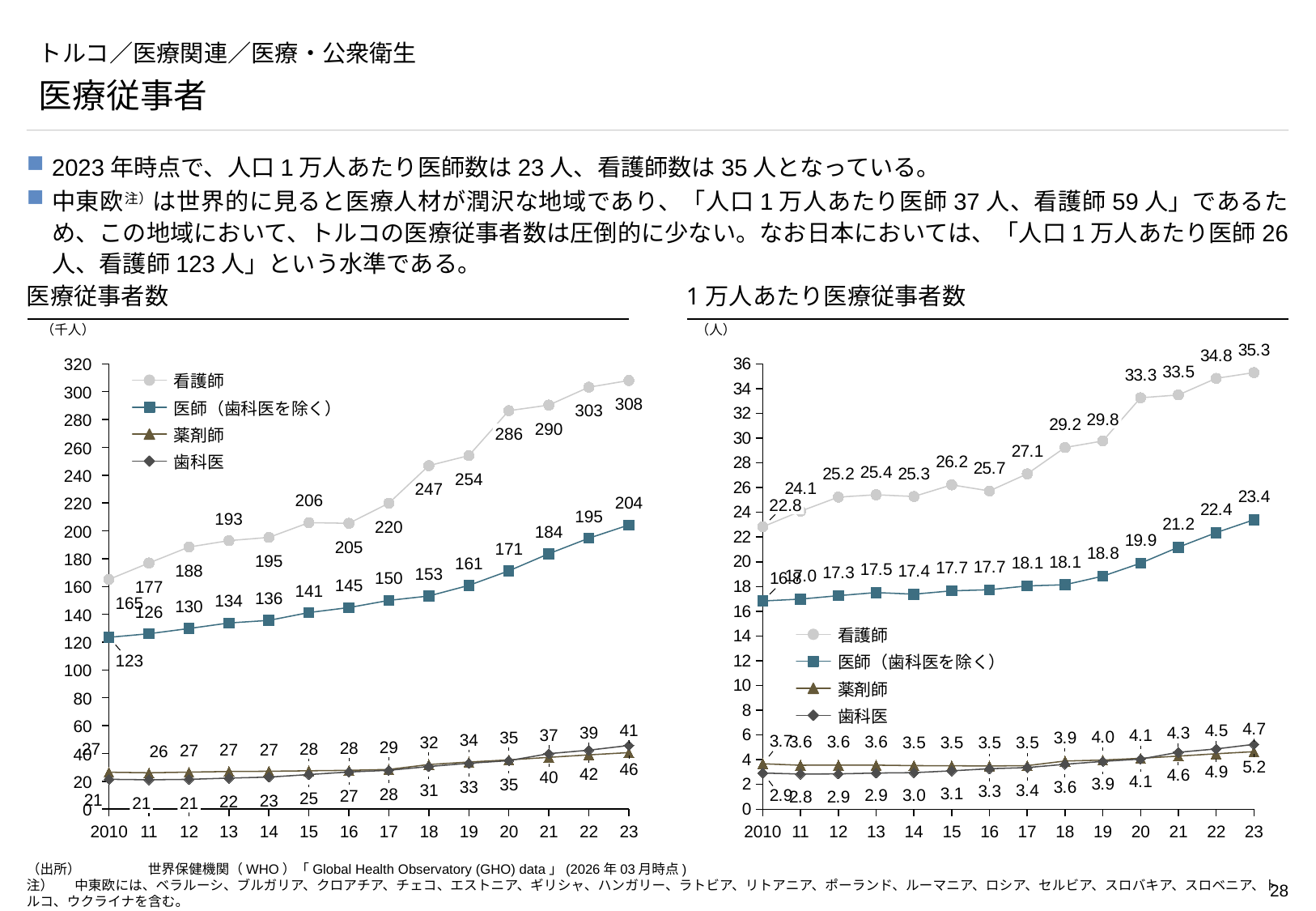
In the left chart (医療従事者数), what is the difference between 看護師 and 医師（歯科医を除く） in 2023? 104 In the left chart (医療従事者数), does the 看護師 series rise or fall from 2010 to 2023? rise In the left chart (医療従事者数), what is the value for 医師（歯科医を除く） in 2010? 123 In the left chart (医療従事者数), how many series does the legend list? 4 In the right chart (1万人あたり医療従事者数), which is larger in 2023, 薬剤師 or 歯科医? 歯科医 In the right chart (1万人あたり医療従事者数), how many years are plotted on the x axis? 14 What type of chart is the right chart (1万人あたり医療従事者数)? line chart In the left chart (医療従事者数), which series has the lowest value in 2010? 歯科医 In the right chart (1万人あたり医療従事者数), what is the difference between the 看護師 values in 2023 and 2010? 12.5 In the right chart (1万人あたり医療従事者数), what is the value for 歯科医 in 2023? 5.2 In the right chart (1万人あたり医療従事者数), what is the value for 看護師 in 2023? 35.3 In the left chart (医療従事者数), what is the value for 看護師 in 2023? 308